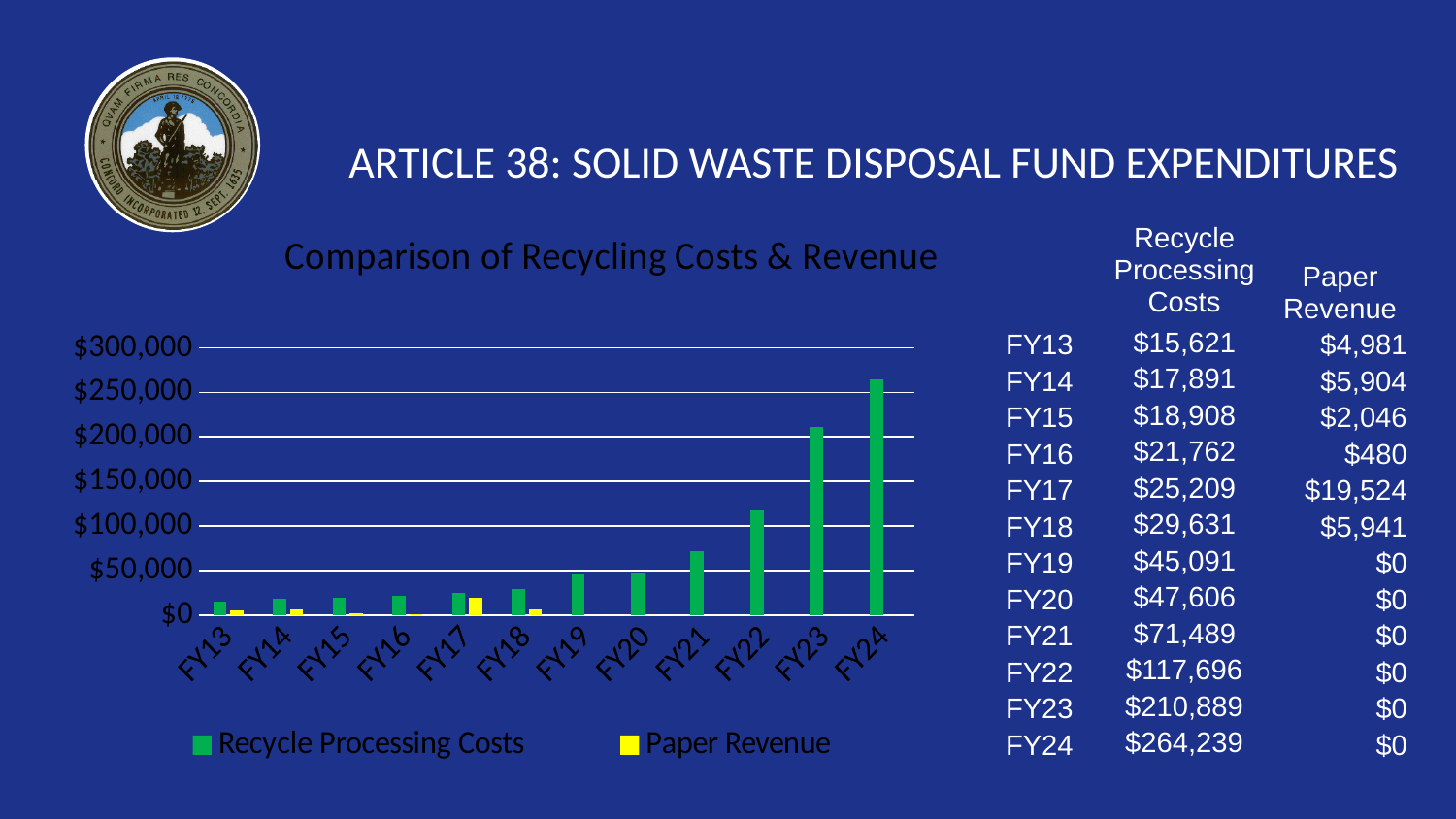
What is the Recycle Processing Costs value for FY24? $264,239 Which fiscal year has the highest Paper Revenue? FY17 Which is larger in FY17, Recycle Processing Costs or Paper Revenue? Recycle Processing Costs How many fiscal years are plotted on the x axis of the chart? 12 Is the Recycle Processing Costs value for FY22 greater or less than $100,000? greater What is the difference in Recycle Processing Costs between FY24 and FY23? $53,350 What is the title of the chart? Comparison of Recycling Costs & Revenue Do Recycle Processing Costs rise or fall from FY13 to FY24? Rise Which fiscal year has the highest Recycle Processing Costs? FY24 How many series does the chart legend list? 2 What is the Paper Revenue value for FY17? $19,524 What type of chart is shown on the slide? Bar chart